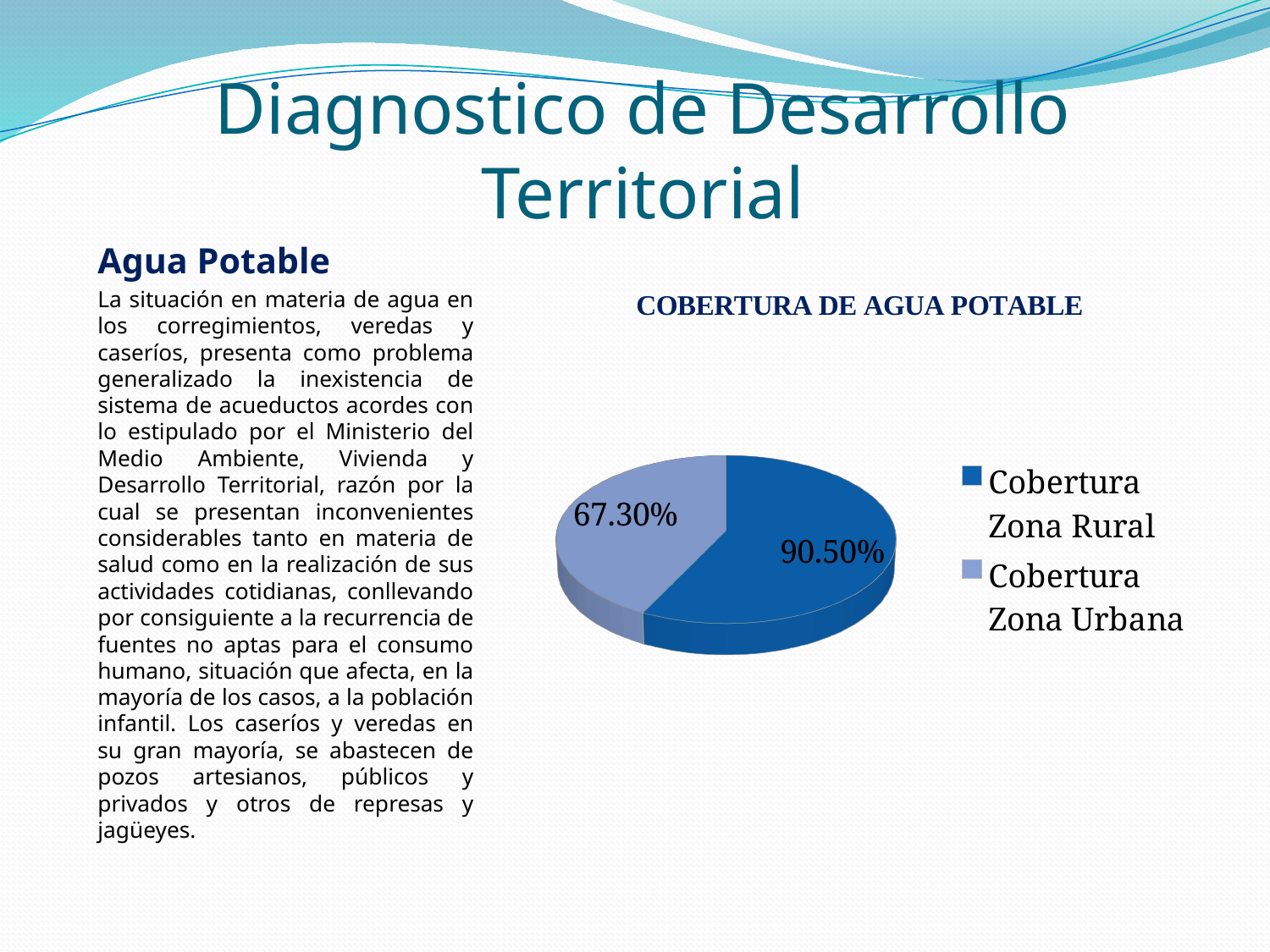
What is the title of the chart? COBERTURA DE AGUA POTABLE How many slices does the pie chart have? 2 What value is shown for Cobertura Zona Rural? 90.50% What type of chart is shown on the slide? pie chart Which category has the lowest value in the chart? Cobertura Zona Urbana How many entries does the legend list? 2 Which category has the highest value in the chart? Cobertura Zona Rural Which is larger, the value for Cobertura Zona Rural or Cobertura Zona Urbana? Cobertura Zona Rural What value is shown for Cobertura Zona Urbana? 67.30% Which legend entry is shown in the darker blue colour? Cobertura Zona Rural What is the difference between the value for Cobertura Zona Rural and the value for Cobertura Zona Urbana? 23.20%